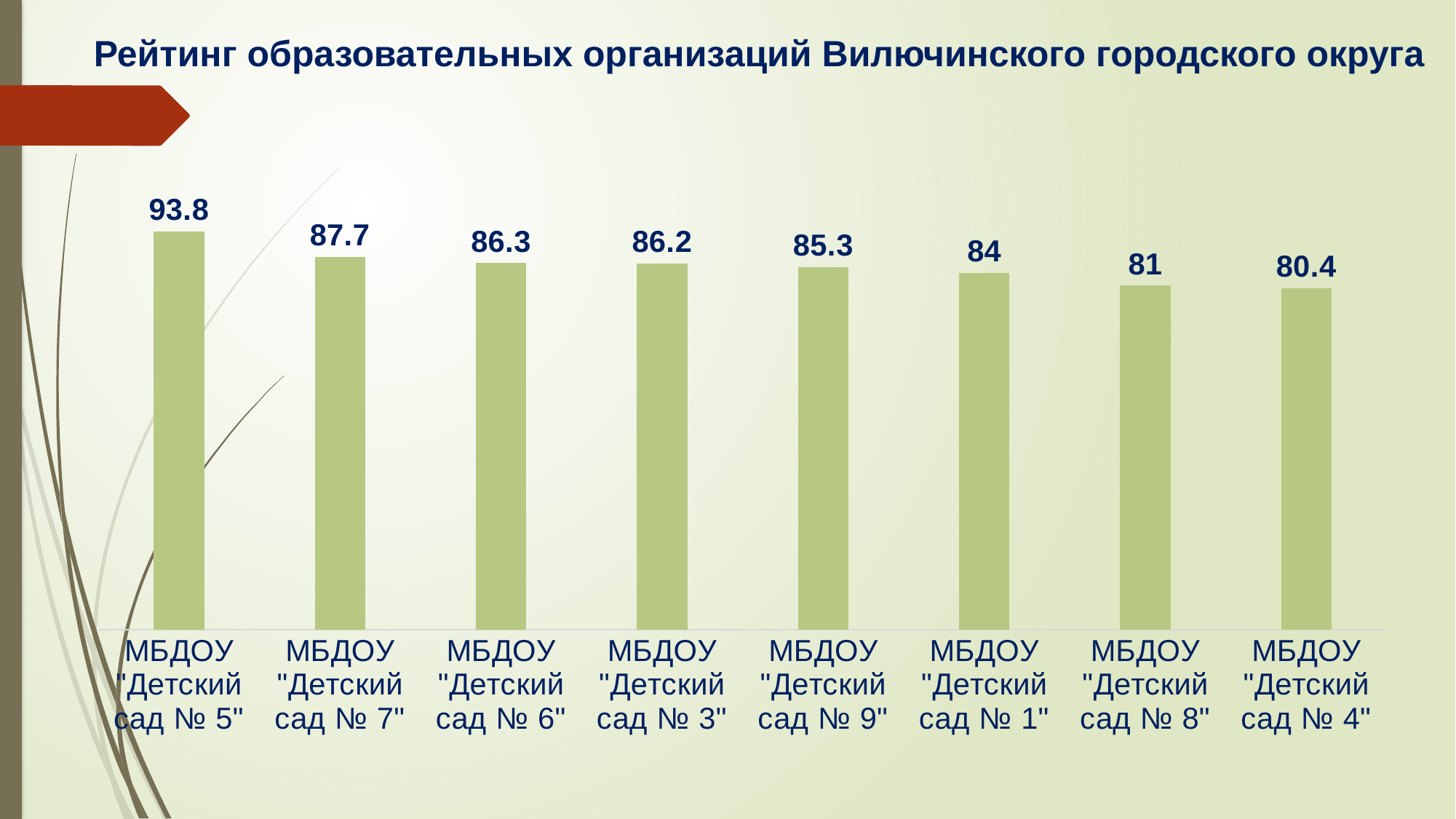
How many organisations are shown in the chart? 8 What is the value for МБДОУ "Детский сад № 1"? 84 Which organisation has the highest value? МБДОУ "Детский сад № 5" What is the value for МБДОУ "Детский сад № 5"? 93.8 What is the value for МБДОУ "Детский сад № 4"? 80.4 Which has a larger value, МБДОУ "Детский сад № 7" or МБДОУ "Детский сад № 8"? МБДОУ "Детский сад № 7" What is the value for МБДОУ "Детский сад № 9"? 85.3 What kind of chart is shown on the slide? Bar chart Which organisation has the lowest value? МБДОУ "Детский сад № 4" What is the difference between the values for МБДОУ "Детский сад № 1" and МБДОУ "Детский сад № 8"? 3 What is the difference between the values for МБДОУ "Детский сад № 5" and МБДОУ "Детский сад № 7"? 6.1 Do the values rise or fall from left to right along the x axis? Fall